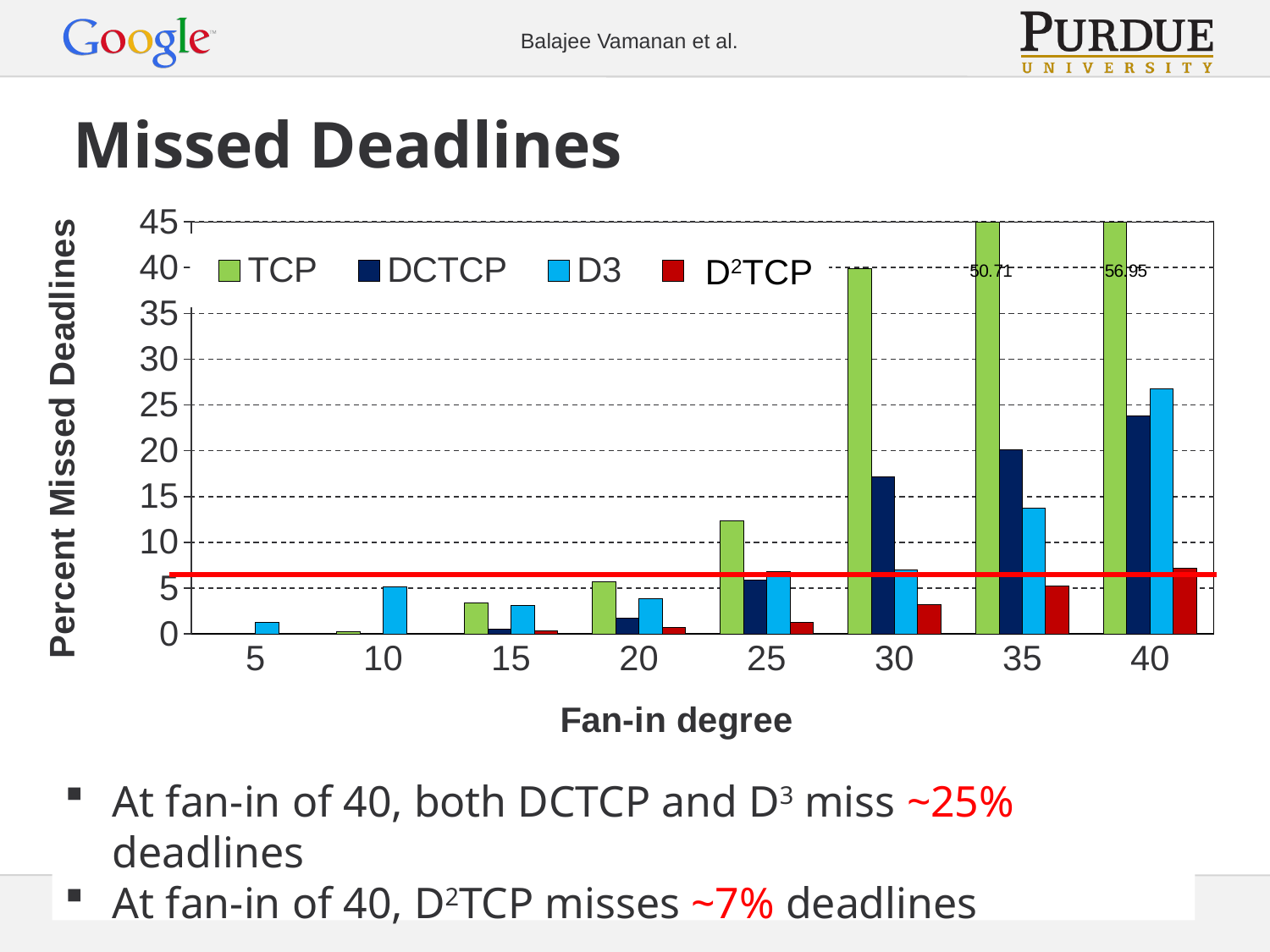
Which series has the lowest value at fan-in degree 40? D²TCP How many series does the legend list? 4 How many fan-in degree categories are plotted on the x axis? 8 What is the difference between the TCP values at fan-in degree 40 and fan-in degree 35? 6.24 What is the title of the x axis? Fan-in degree Is the value for D²TCP at fan-in degree 30 greater or less than 5? less Is the value for DCTCP at fan-in degree 40 greater or less than 20? greater What is the value for TCP at fan-in degree 35? 50.71 What kind of chart is shown on the slide? bar chart What is the value for TCP at fan-in degree 40? 56.95 Which series has the highest value at fan-in degree 40? TCP At fan-in degree 35, which is larger, DCTCP or D3? DCTCP